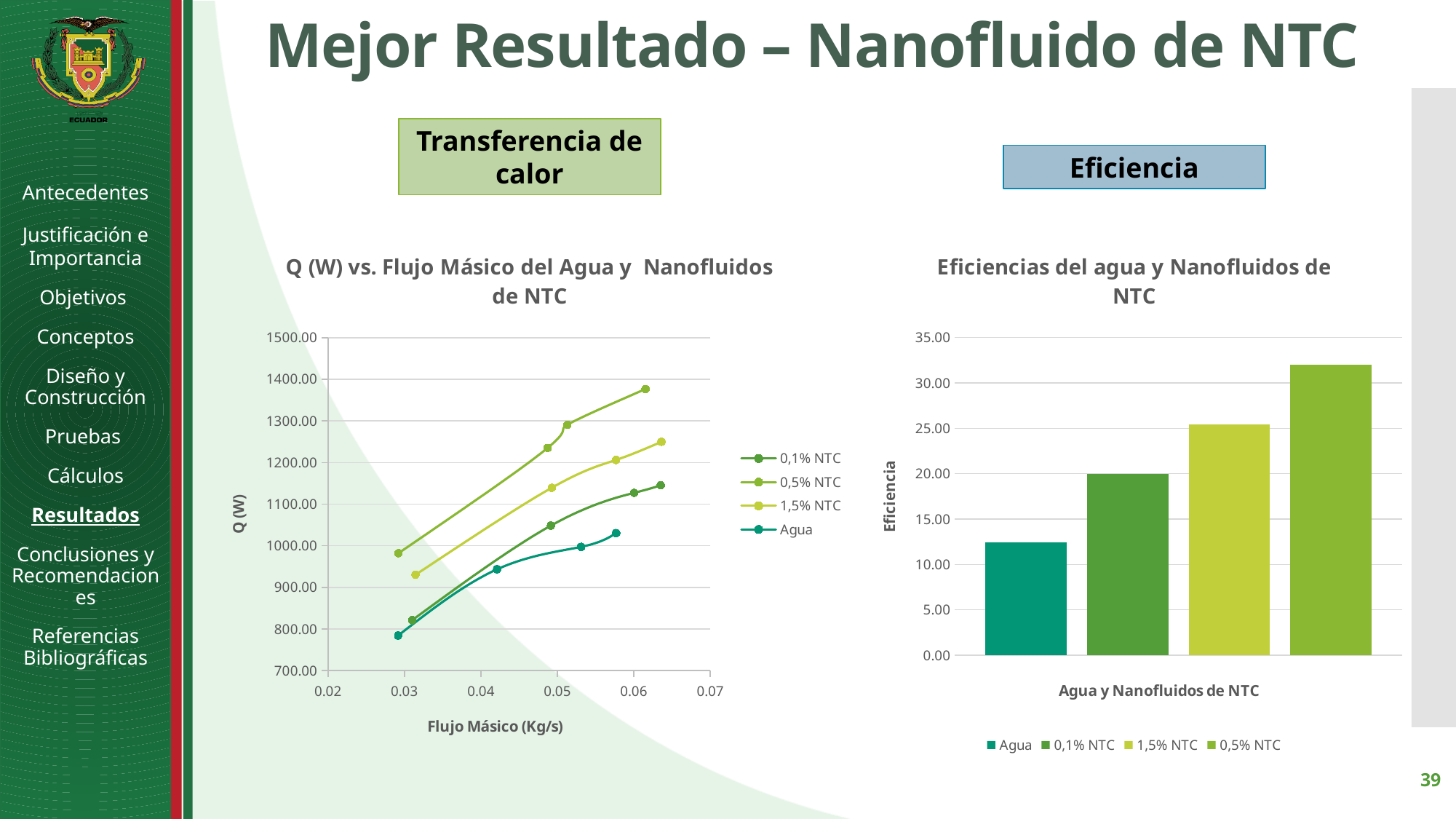
How many series does the legend list in the chart titled 'Q (W) vs. Flujo Másico del Agua y Nanofluidos de NTC'? 4 What kind of chart is the chart titled 'Q (W) vs. Flujo Másico del Agua y Nanofluidos de NTC'? Line chart In the chart titled 'Eficiencias del agua y Nanofluidos de NTC', which category has the lowest efficiency? Agua In the chart titled 'Eficiencias del agua y Nanofluidos de NTC', which category has the highest efficiency? 0,5% NTC What kind of chart is the chart titled 'Eficiencias del agua y Nanofluidos de NTC'? Bar chart How many bars are shown in the chart titled 'Eficiencias del agua y Nanofluidos de NTC'? 4 In the chart titled 'Q (W) vs. Flujo Másico del Agua y Nanofluidos de NTC', do the values for the 0,5% NTC series rise or fall as the mass flow increases? Rise In the chart titled 'Eficiencias del agua y Nanofluidos de NTC', is the value for 0,5% NTC greater or less than 30.00? greater In the chart titled 'Eficiencias del agua y Nanofluidos de NTC', which is larger, the value for 1,5% NTC or the value for 0,1% NTC? 1,5% NTC In the chart titled 'Eficiencias del agua y Nanofluidos de NTC', is the value for Agua greater or less than 15.00? less In the chart titled 'Q (W) vs. Flujo Másico del Agua y Nanofluidos de NTC', which series reaches the highest Q value? 0,5% NTC